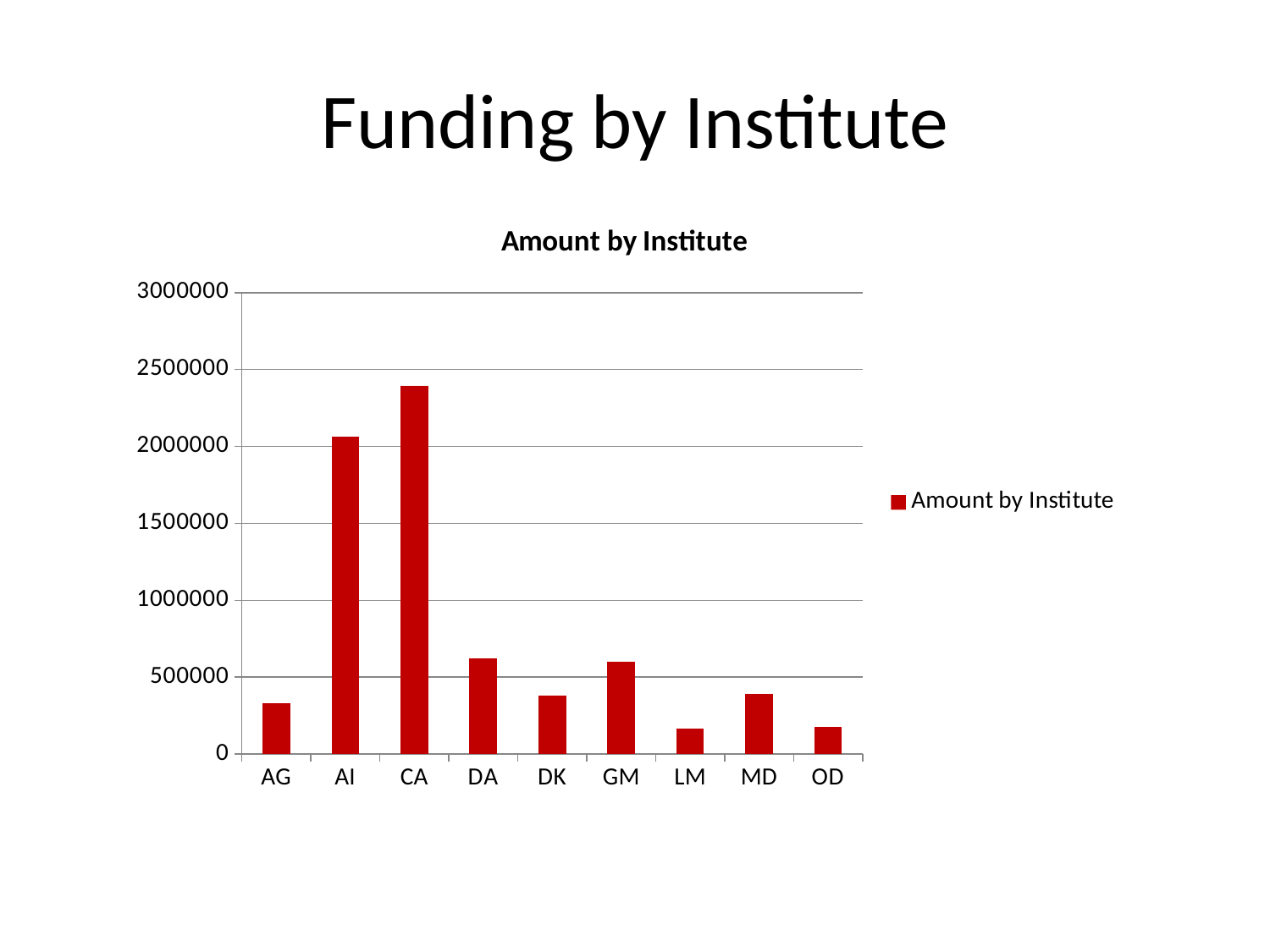
How many series does the legend list? 1 Is the value for LM greater or less than 500000? less Which has a larger funding amount, DA or DK? DA Is the value for CA greater or less than 2500000? less What kind of chart is shown on the slide? bar chart What is the title of the chart? Amount by Institute Which has a larger funding amount, AI or CA? CA How many institutes are shown on the x axis of the chart? 9 Is the value for GM greater or less than 500000? greater Which institute has the highest funding amount? CA